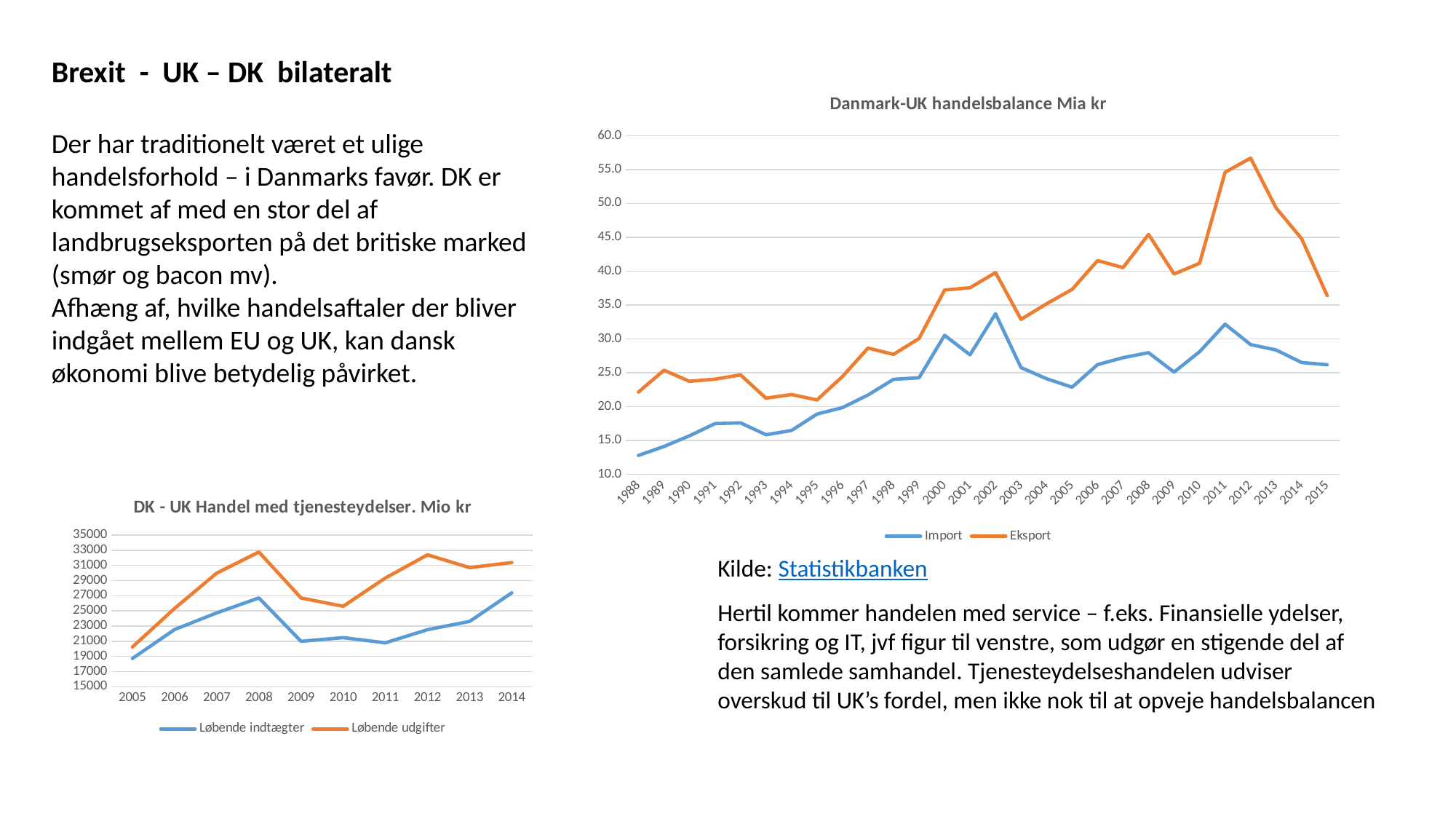
In the 'DK - UK Handel med tjenesteydelser. Mio kr' chart, in which year is Løbende indtægter at its lowest? 2005 In the 'Danmark-UK handelsbalance Mia kr' chart, does Eksport rise or fall from 2012 to 2015? fall How many series does the legend of the 'Danmark-UK handelsbalance Mia kr' chart list? 2 In the 'Danmark-UK handelsbalance Mia kr' chart, is the Eksport value for 2015 greater or less than 40.0? less What kind of chart is the 'Danmark-UK handelsbalance Mia kr' chart? line chart What kind of chart is the 'DK - UK Handel med tjenesteydelser. Mio kr' chart? line chart In the 'Danmark-UK handelsbalance Mia kr' chart, which is larger in 2002, Import or Eksport? Eksport In the 'Danmark-UK handelsbalance Mia kr' chart, how many years are shown on the x axis? 28 In the 'Danmark-UK handelsbalance Mia kr' chart, in which year does Eksport reach its highest value? 2012 In the 'Danmark-UK handelsbalance Mia kr' chart, is the Eksport value for 2012 greater or less than 55.0? greater In the 'DK - UK Handel med tjenesteydelser. Mio kr' chart, is the Løbende udgifter value for 2010 greater or less than 27000? less In the 'Danmark-UK handelsbalance Mia kr' chart, in which year is Import at its lowest? 1988